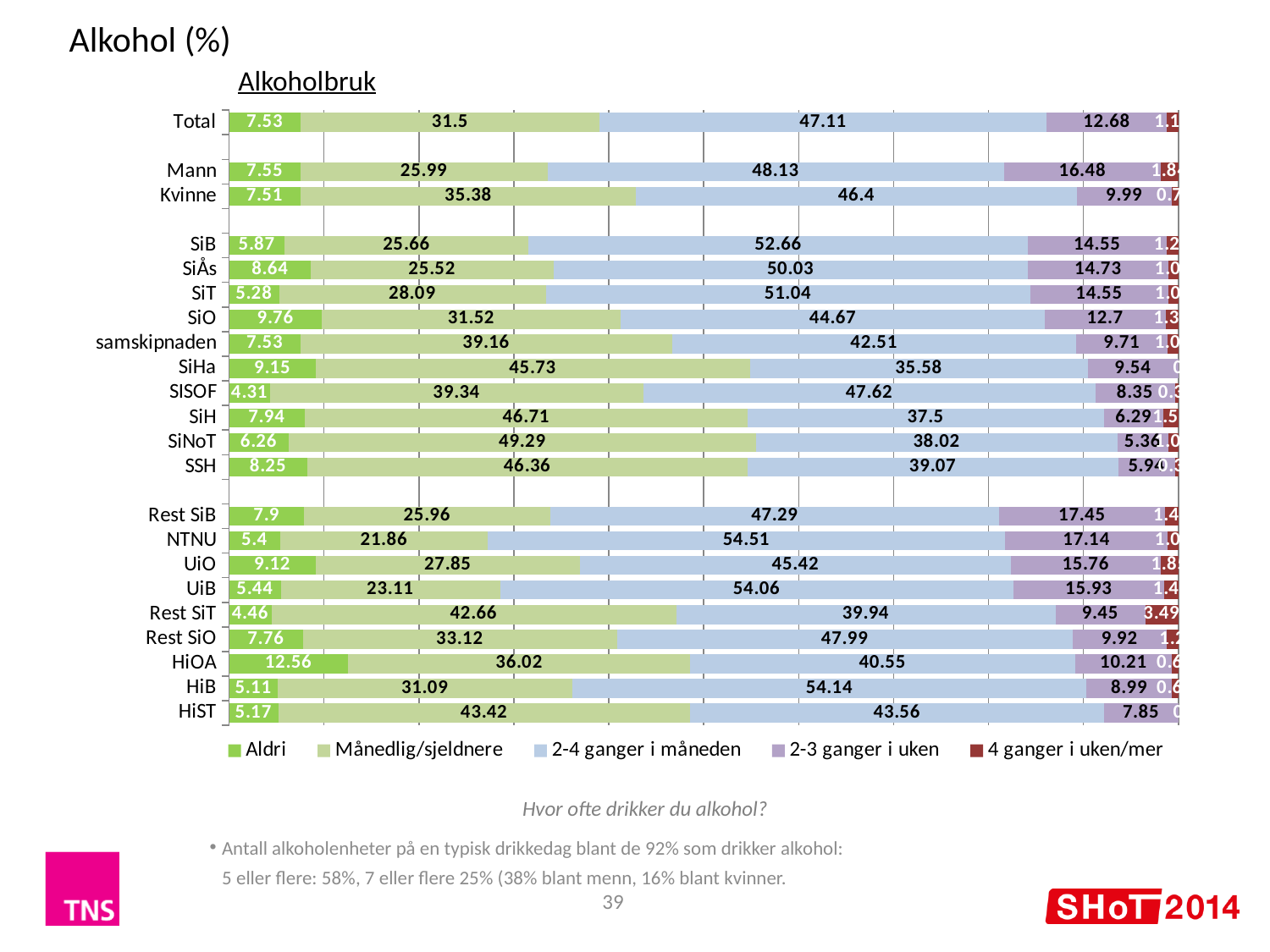
What is the difference between Mann and Kvinne in the "2-3 ganger i uken" series? 6.49 What is the "4 ganger i uken/mer" value for Rest SiT? 3.49 What is the "Aldri" value for HiOA? 12.56 What type of chart is shown on the slide? Stacked bar chart What is the value for Total in the "2-4 ganger i måneden" series? 47.11 How many series does the legend list? 5 What is the "2-4 ganger i måneden" value for SiB? 52.66 Which has the larger "Månedlig/sjeldnere" value, Mann or Kvinne? Kvinne Which category has the highest "Månedlig/sjeldnere" value? SiNoT Which category has the lowest "Månedlig/sjeldnere" value? NTNU Which category has the highest "Aldri" value? HiOA How many categories are shown on the y axis of the chart? 22